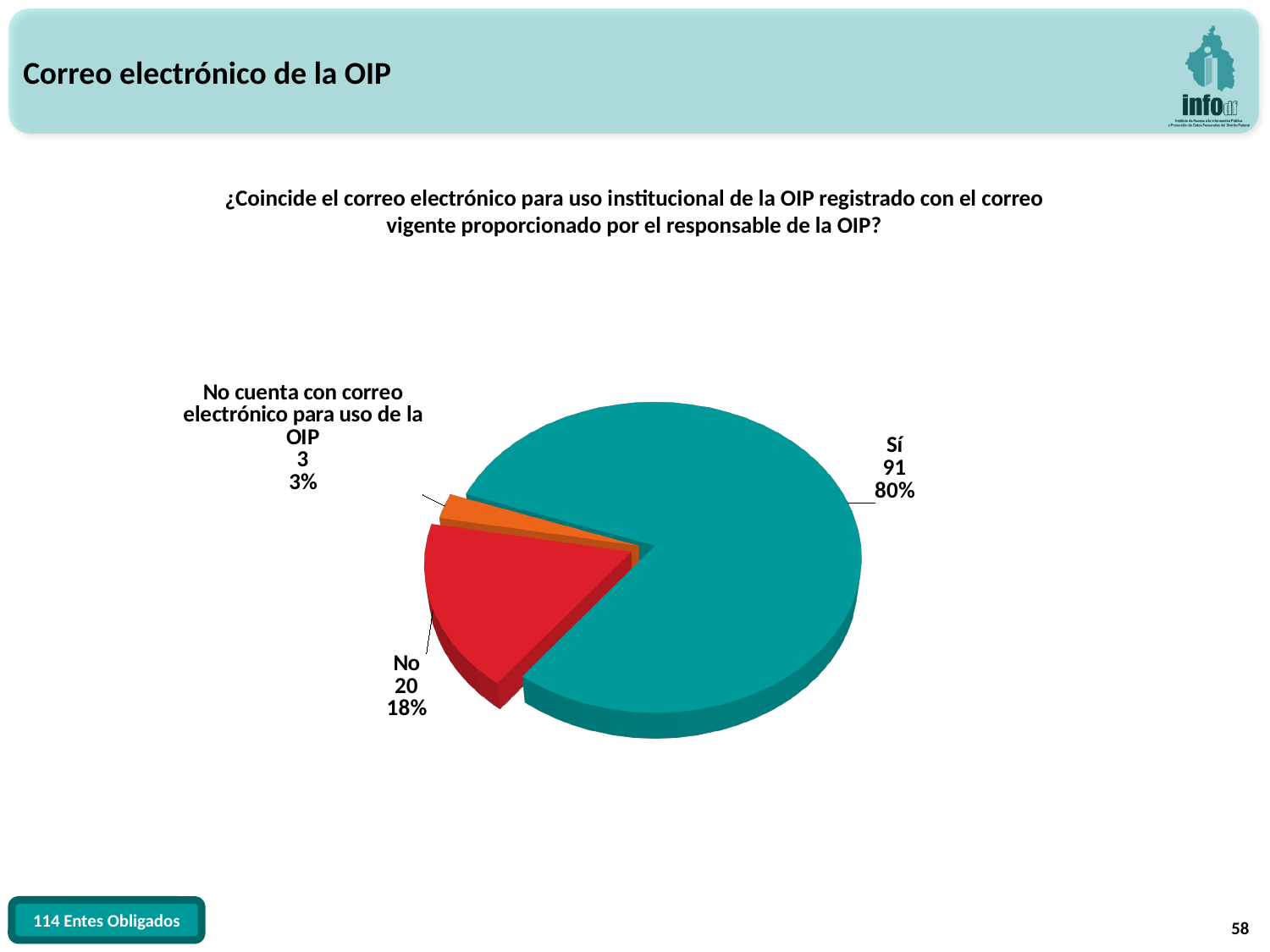
What kind of chart is shown on the slide? pie chart What is the count for "No cuenta con correo electrónico para uso de la OIP"? 3 Which is larger, the count for "No" or the count for "No cuenta con correo electrónico para uso de la OIP"? No What percentage does the "No" slice represent? 18% Which category has the largest slice? Sí What is the difference between the counts for "Sí" and "No"? 71 How many slices does the pie chart have? 3 What percentage does the "Sí" slice represent? 80% What is the count for the "Sí" slice? 91 Which category has the smallest slice? No cuenta con correo electrónico para uso de la OIP What colour is the "Sí" slice? teal What is the total of the three counts shown on the pie chart? 114